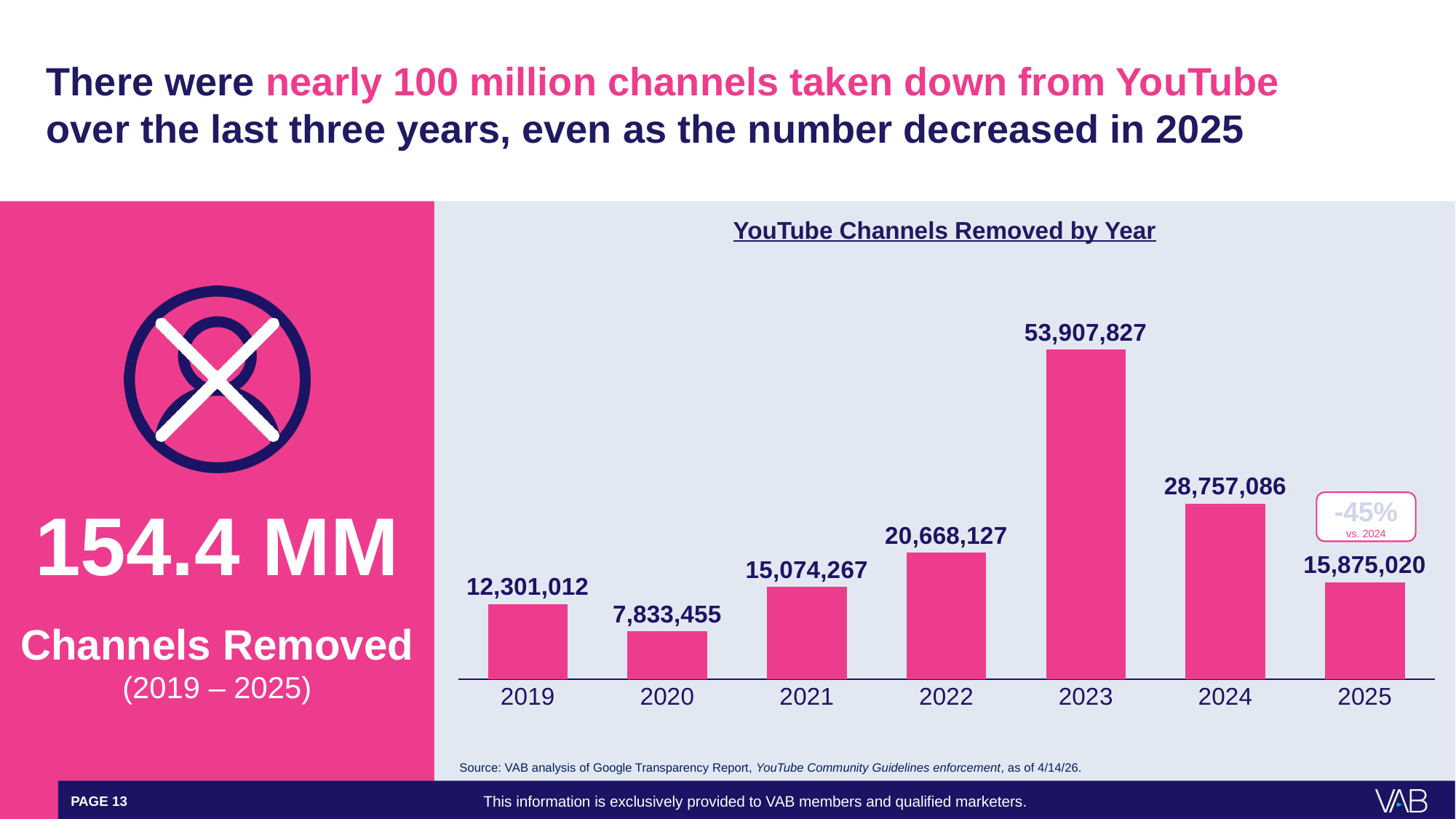
What is the difference between the number of channels removed in 2024 and in 2025? 12,882,066 Which year had more channels removed, 2021 or 2025? 2025 What is the title of the chart? YouTube Channels Removed by Year How many YouTube channels were removed in 2020? 7,833,455 What kind of chart is shown on the slide? Bar chart What is the difference between the number of channels removed in 2023 and in 2024? 25,150,741 How many YouTube channels were removed in 2025? 15,875,020 Which year had the highest number of channels removed? 2023 How many years are shown on the x axis of the chart? 7 Which year had the lowest number of channels removed? 2020 Did the number of channels removed rise or fall from 2020 to 2023? Rise How many YouTube channels were removed in 2023? 53,907,827